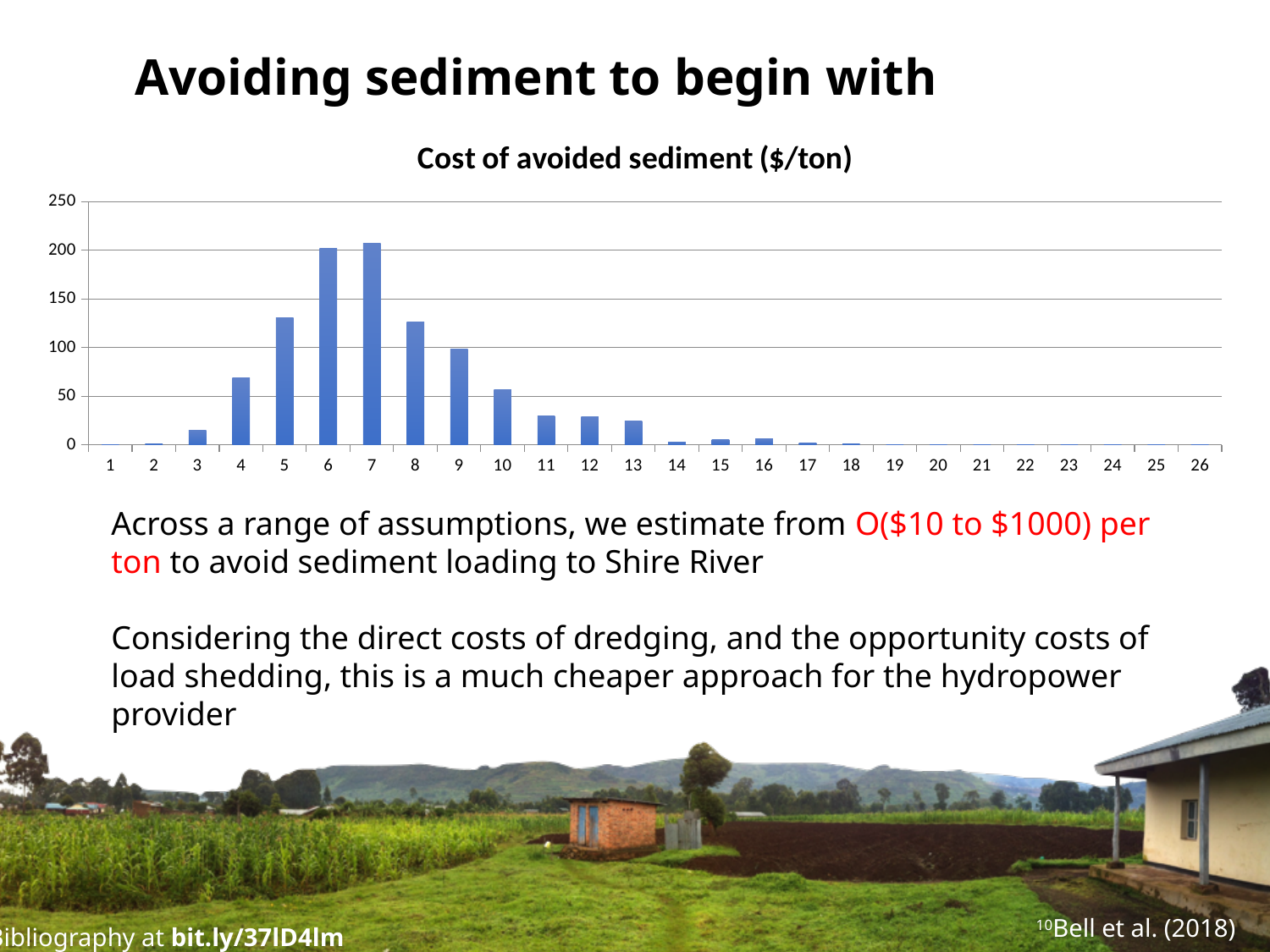
Is the value for category 5 greater or less than 100? greater Which has the larger value, category 5 or category 9? 5 Which category has the highest bar in the chart? 7 What kind of chart is shown on the slide? bar chart Is the value for category 7 greater or less than 200? greater Is the value for category 8 greater or less than 100? greater Which has the larger value, category 4 or category 10? 4 What is the title of the chart? Cost of avoided sediment ($/ton) How many categories are shown on the x axis of the chart? 26 Do the values rise or fall from category 7 to category 13? fall